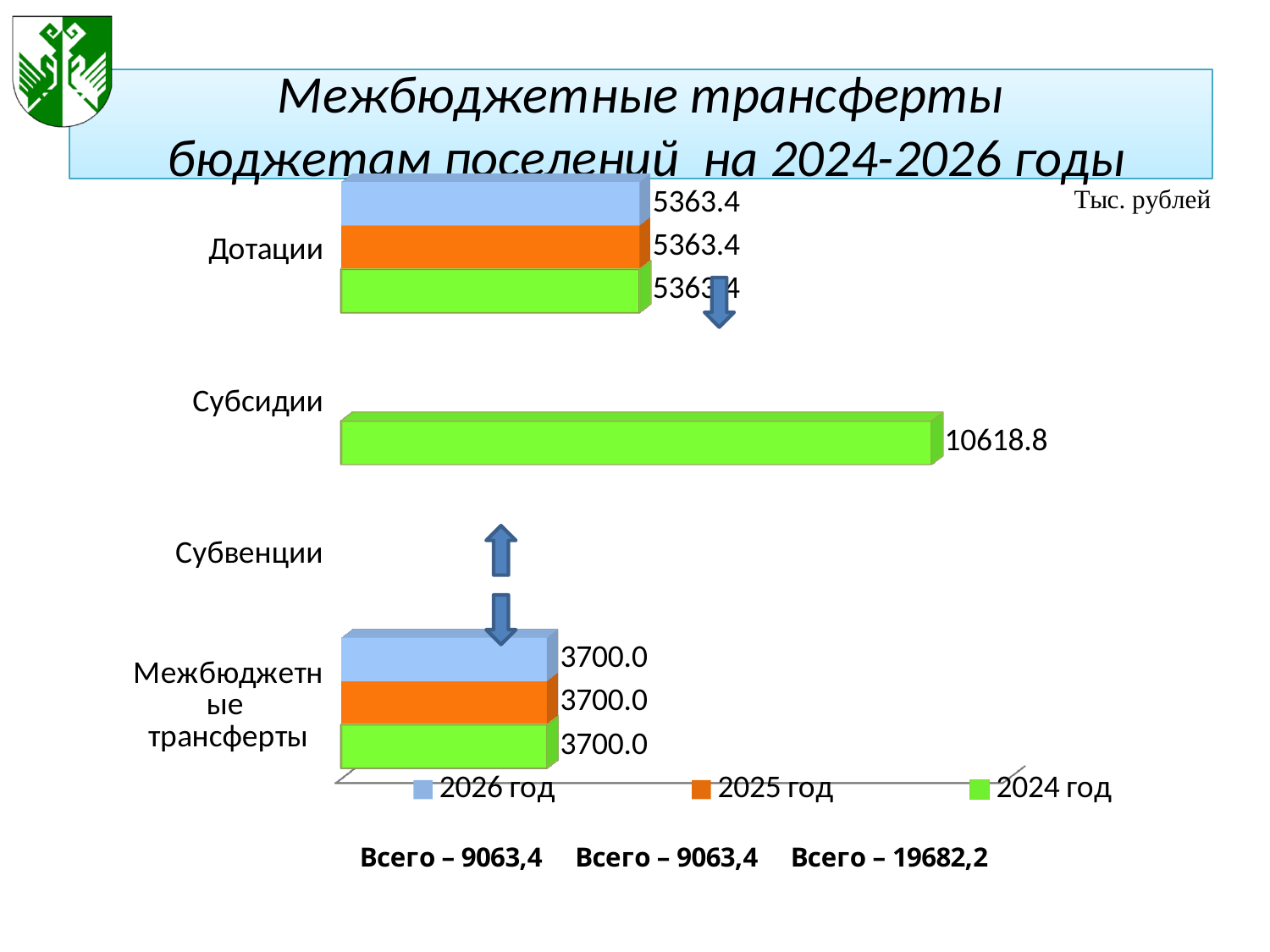
What is the value for Межбюджетные трансферты in the 2025 год series? 3700.0 What is the value for Дотации in the 2026 год series? 5363.4 What is the value for Субсидии in the 2024 год series? 10618.8 Which category has the highest value in the 2024 год series? Субсидии How many categories are shown on the vertical axis? 4 What is the difference between the 2024 год values for Субсидии and Дотации? 5255.4 Which is larger in the 2024 год series: Дотации or Межбюджетные трансферты? Дотации What is the difference between the 2025 год values for Дотации and Межбюджетные трансферты? 1663.4 How many series does the legend list? 3 What is the value for Дотации in the 2024 год series? 5363.4 What kind of chart is shown on the slide? Bar chart Which category has the lowest value in the 2026 год series? Межбюджетные трансферты